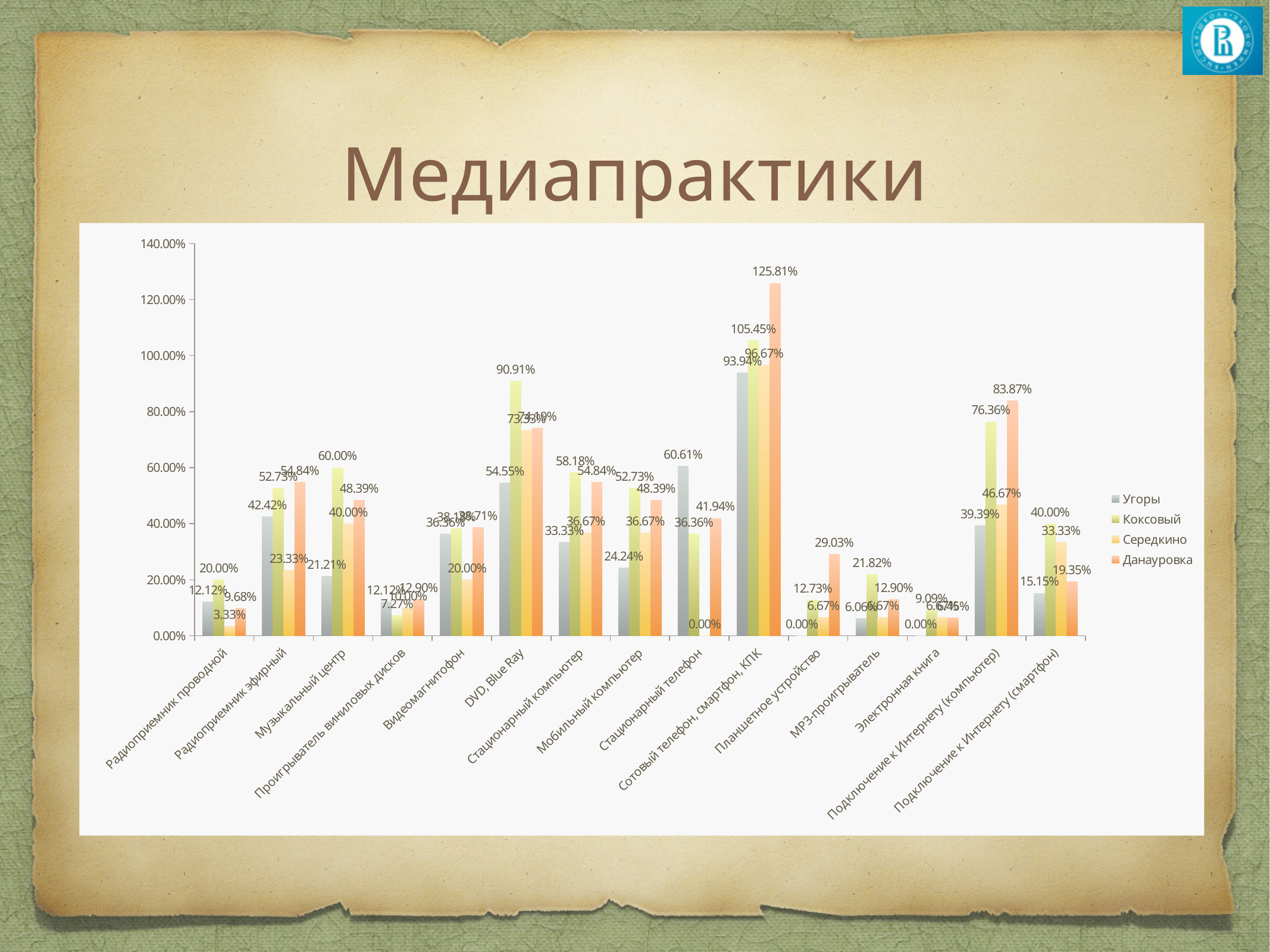
Is the value for Коксовый in 'Подключение к Интернету (компьютер)' greater or less than 60%? greater What is the value for Коксовый in the category 'DVD, Blue Ray'? 90.91% What is the difference between Коксовый and Угоры in the category 'Музыкальный центр'? 38.79% Which series has the highest value in the category 'Подключение к Интернету (компьютер)'? Данауровка What is the title of the slide? Медиапрактики Which series has the lowest value in the category 'Радиоприемник проводной'? Середкино What is the value for Данауровка in the category 'Сотовый телефон, смартфон, КПК'? 125.81% How many series does the legend list? 4 Which is larger in the category 'Планшетное устройство': Данауровка or Коксовый? Данауровка How many categories are shown on the x axis? 15 What is the value for Угоры in the category 'Стационарный телефон'? 60.61% What kind of chart is shown on the slide? bar chart